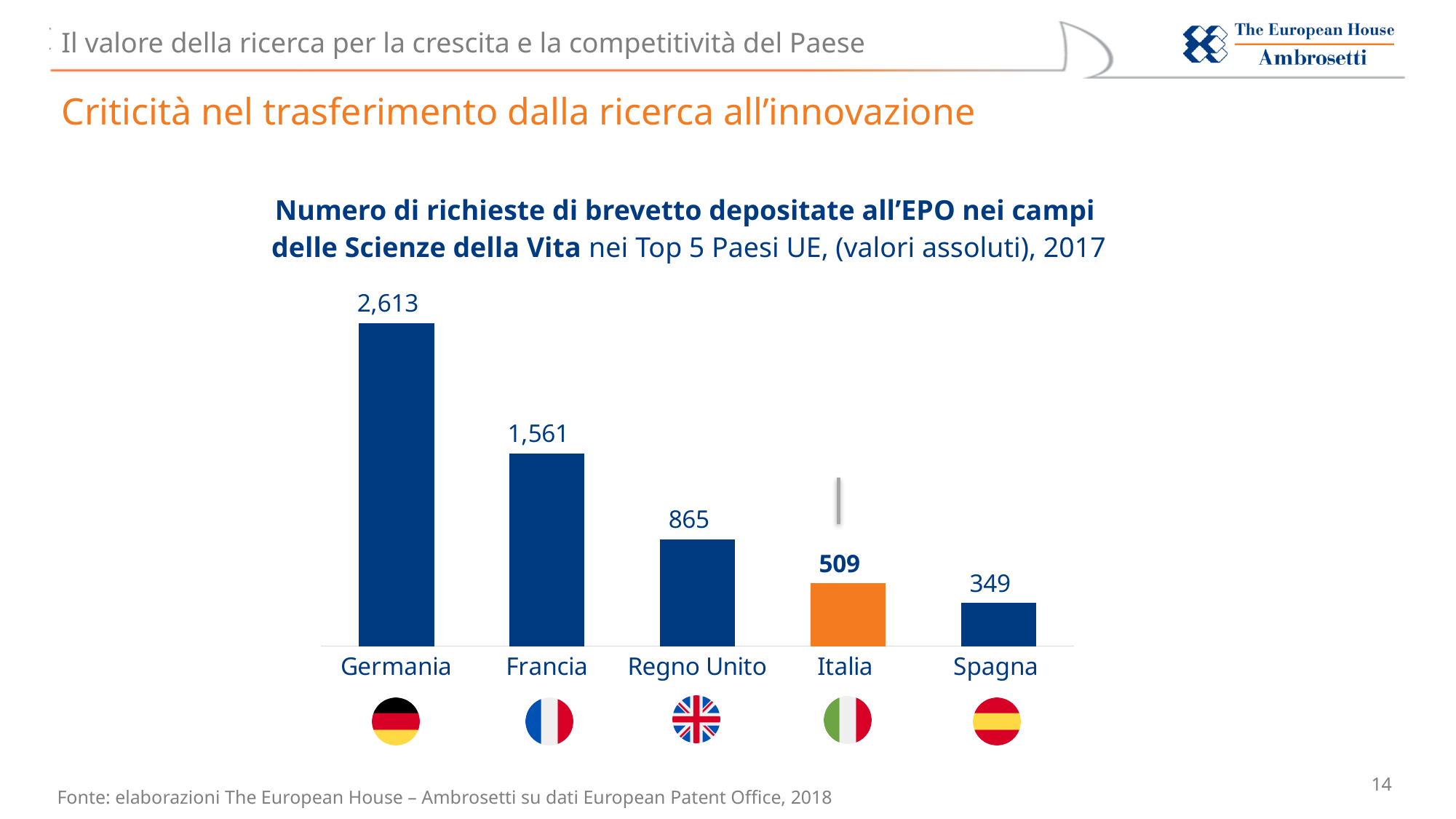
How many countries are shown in the chart? 5 What is the difference between the values for Germania and Francia? 1,052 Which country's bar is highlighted in orange? Italia Which country has the lowest number of patent applications? Spagna What kind of chart is shown on the slide? Bar chart Which has a larger value, Francia or Regno Unito? Francia What is the difference between the values for Regno Unito and Italia? 356 What is the value shown for Italia? 509 Which country has the highest number of patent applications? Germania What is the value shown for Regno Unito? 865 What is the value shown for Spagna? 349 What is the number of patent applications for Germania? 2,613